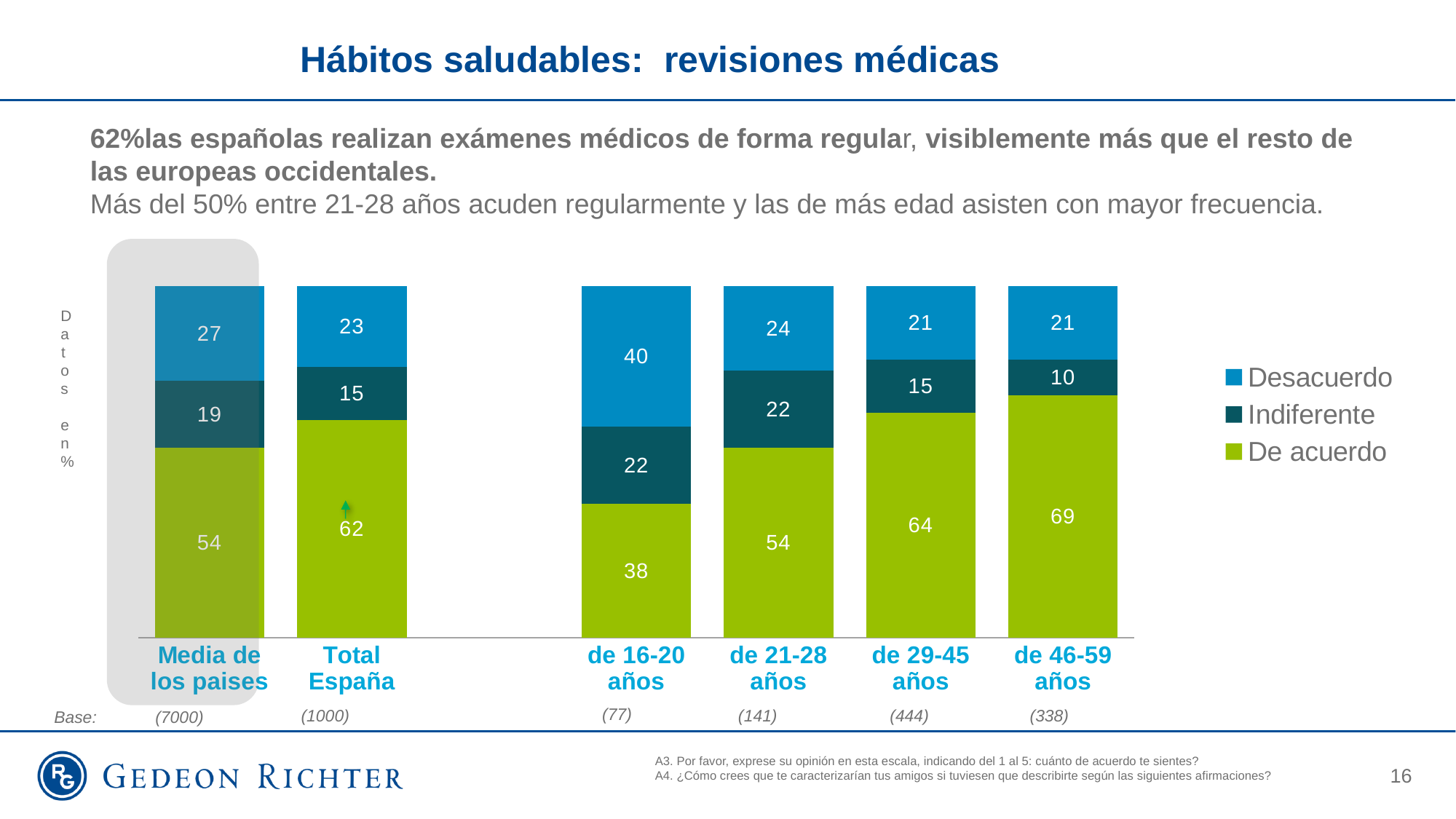
Which is larger, the 'Indiferente' value for 'de 21-28 años' or for 'de 46-59 años'? de 21-28 años How many series does the legend list? 3 What is the 'Indiferente' value for 'Media de los paises'? 19 What is the difference between the 'De acuerdo' values for Total España and Media de los paises? 8 Which series is shown in light green in the chart? De acuerdo What is the total of the stacked bar for 'de 29-45 años'? 100 What is the 'De acuerdo' value for Total España? 62 What is the 'Desacuerdo' value for the 'de 16-20 años' group? 40 How many categories are shown on the x axis of the chart? 6 Which category has the lowest 'De acuerdo' value? de 16-20 años Which category has the highest 'De acuerdo' value? de 46-59 años What kind of chart is shown on the slide? Stacked bar chart